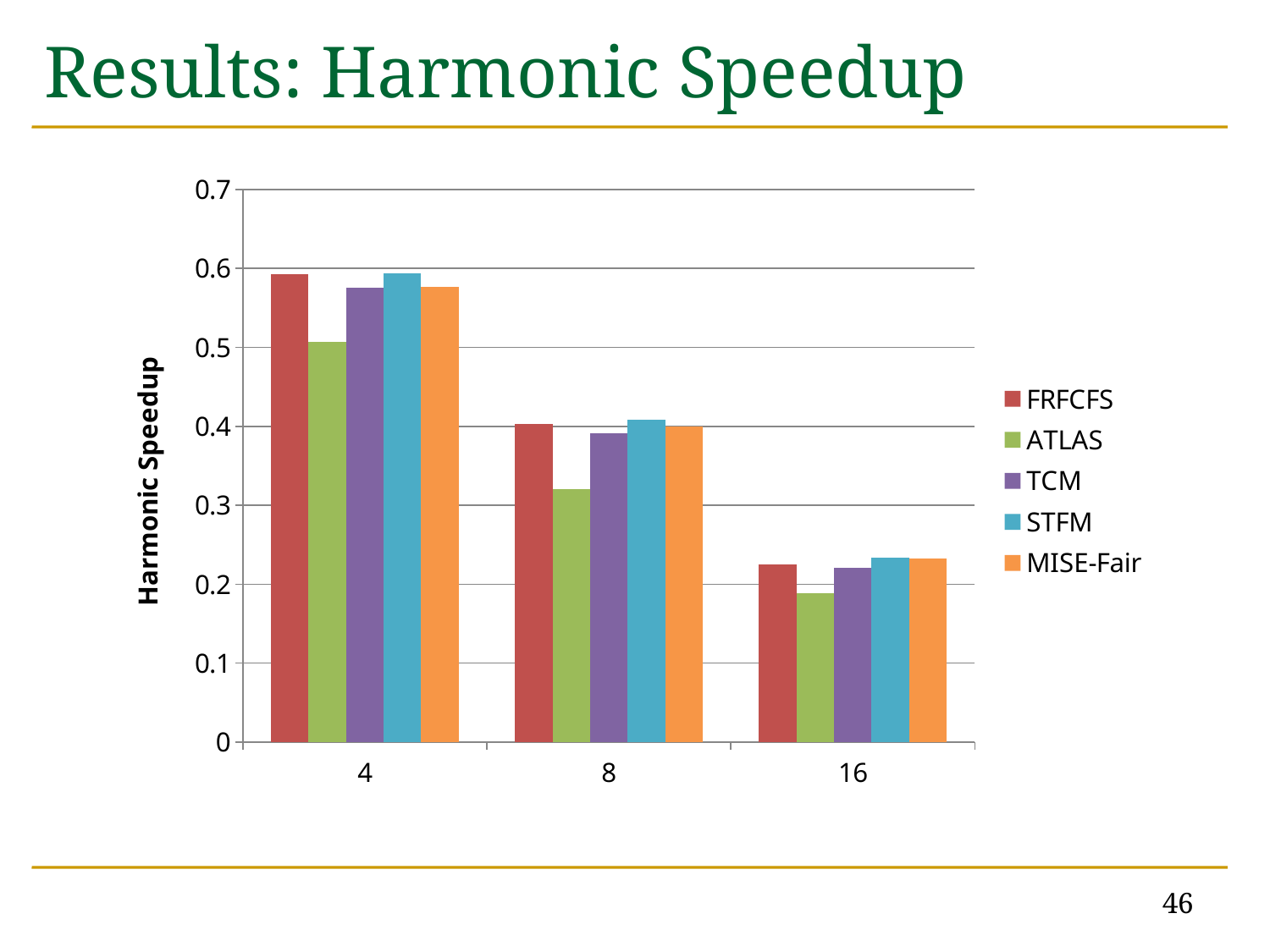
Which series has the lowest harmonic speedup at category 16? ATLAS Do the harmonic speedup values rise or fall as the x-axis category increases from 4 to 16? fall How many series does the legend list? 5 What kind of chart is shown on the slide? bar chart At category 8, which is larger: the value for FRFCFS or the value for ATLAS? FRFCFS How many categories are shown on the x axis? 3 Is the value for FRFCFS at category 4 greater or less than 0.5? greater What is the label of the y axis? Harmonic Speedup Is the value for ATLAS at category 8 greater or less than 0.4? less Is the value for ATLAS at category 16 greater or less than 0.2? less Which series has the lowest harmonic speedup at category 4? ATLAS